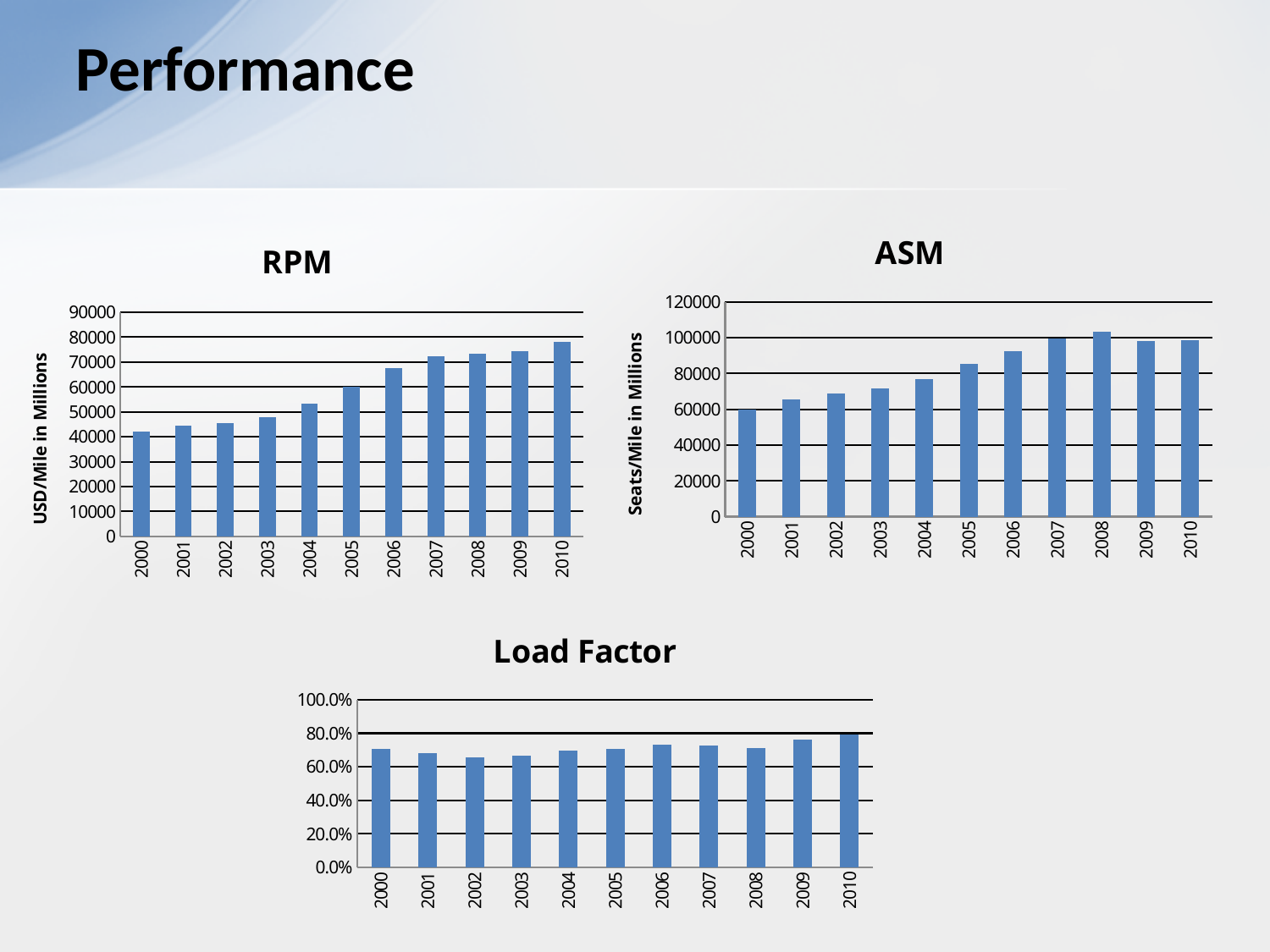
In the RPM chart, which year has the highest value? 2010 In the Load Factor chart, is the value for 2009 greater or less than 80.0%? less In the ASM chart, is the value for 2004 greater or less than 80000? less How many years are shown on the x axis of the Load Factor chart? 11 In the ASM chart, which year has the lowest value? 2000 What is the y-axis label of the ASM chart? Seats/Mile in Millions In the ASM chart, which year has the highest value? 2008 In the RPM chart, do the values generally rise or fall from 2000 to 2010? rise In the Load Factor chart, which year has the lowest value? 2002 In the RPM chart, is the value for 2004 greater or less than 50000? greater In the ASM chart, which is larger, the value for 2005 or the value for 2006? 2006 In the RPM chart, which year has the lowest value? 2000